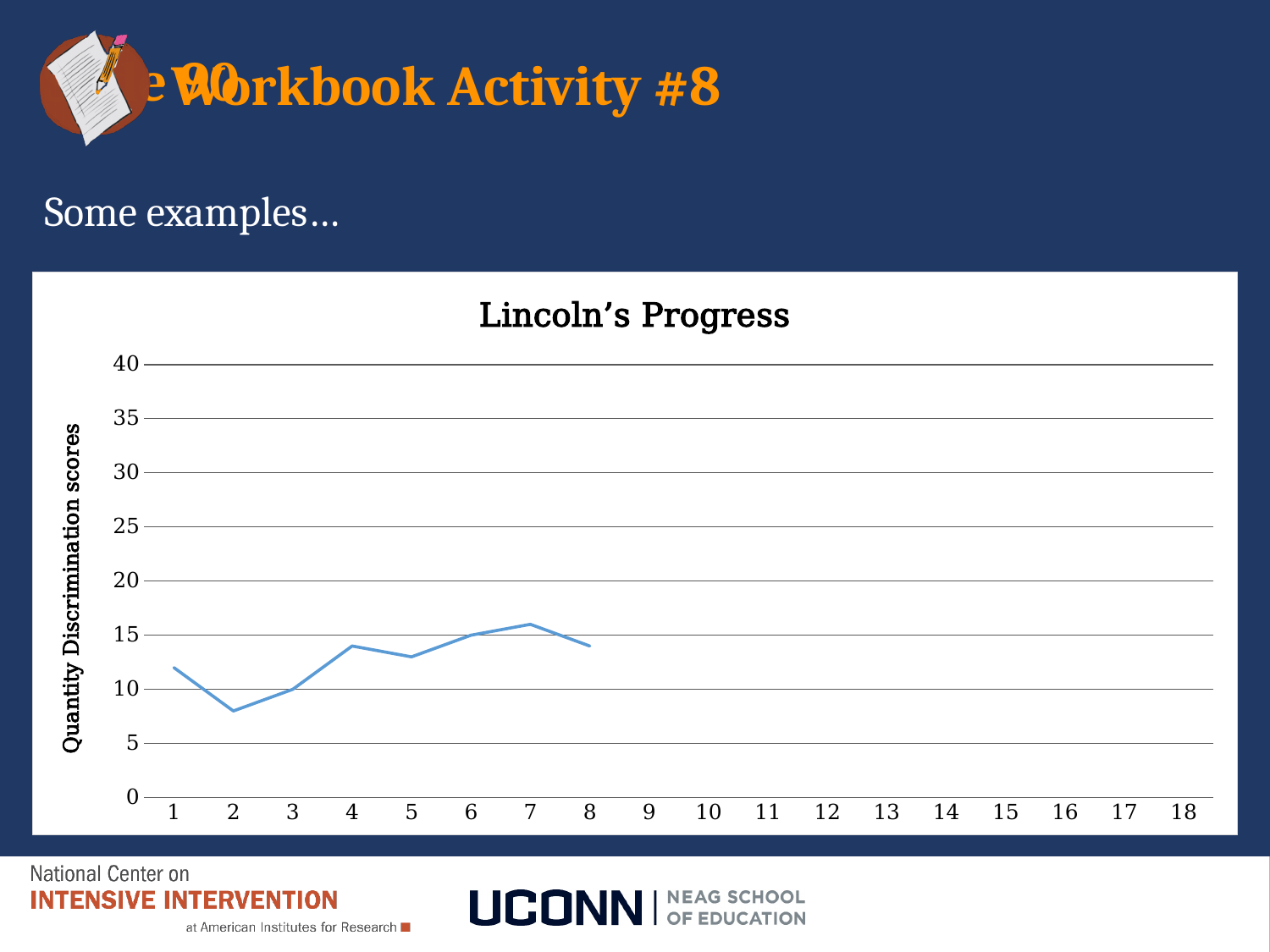
Is the value at point 8 greater or less than 15? less What kind of chart is shown on the slide? line chart Is the value at point 2 greater or less than 10? less What is the title of the chart? Lincoln's Progress Is the value at point 7 greater or less than 15? greater Do the values generally rise or fall from point 2 to point 7? rise Which is larger, the value at point 4 or the value at point 2? point 4 What is the label on the vertical axis of the chart? Quantity Discrimination scores At which x-axis point does the line reach its lowest value? 2 At which x-axis point does the line reach its highest value? 7 How many data points are plotted on the line in the chart? 8